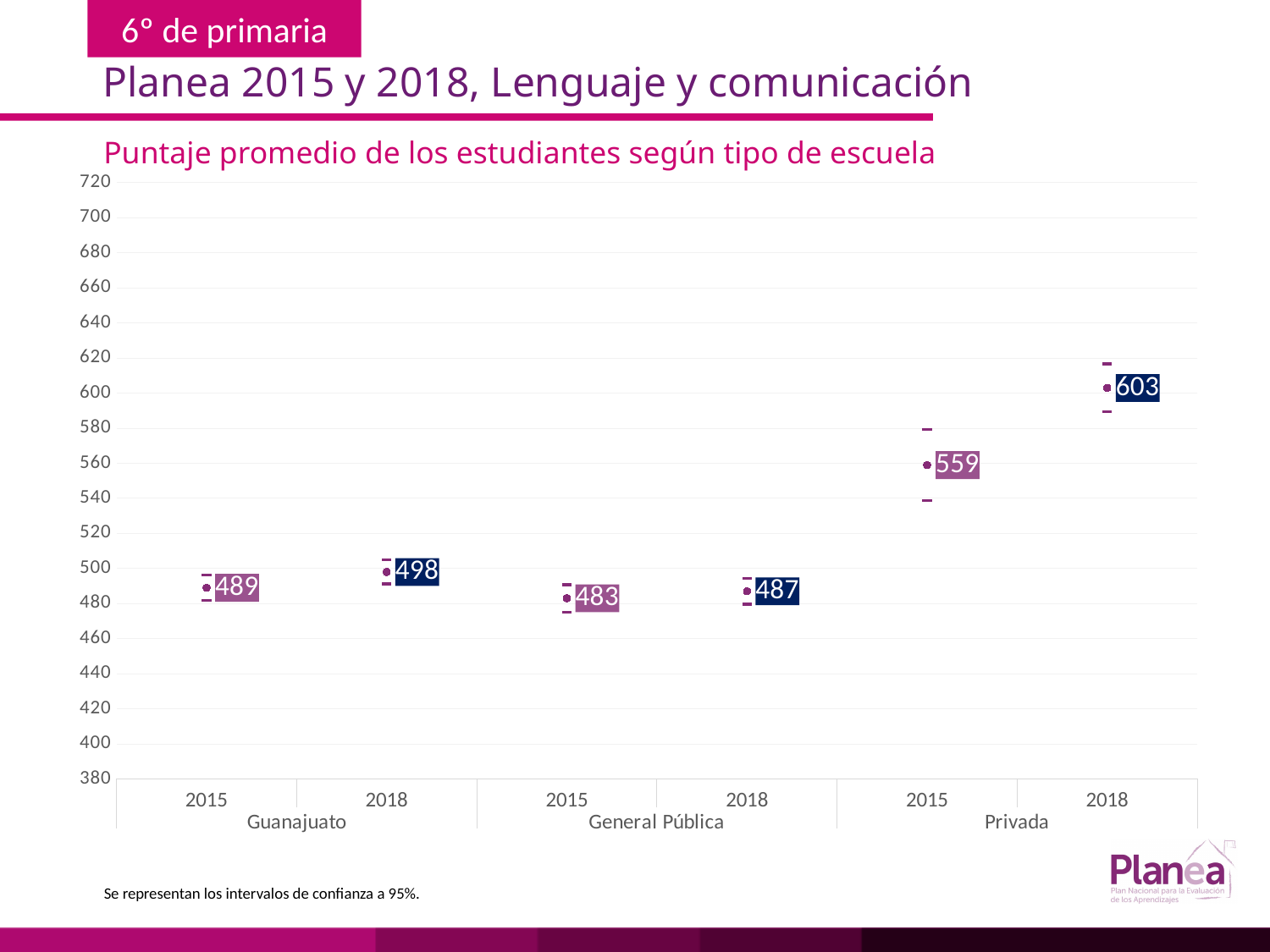
How many data points are plotted on the chart? 6 What is the difference between the Privada scores in 2018 and 2015? 44 What is the average score for Privada in 2018? 603 What is the title of the chart? Puntaje promedio de los estudiantes según tipo de escuela Which is larger, the 2018 score for Guanajuato or the 2018 score for General Pública? Guanajuato What is the average score for Guanajuato in 2018? 498 Which school type and year has the highest average score? Privada 2018 What is the average score for Guanajuato in 2015? 489 What is the average score for General Pública in 2015? 483 Which school type and year has the lowest average score? General Pública 2015 What is the difference between the Guanajuato scores in 2018 and 2015? 9 Does the score for each school type rise or fall from 2015 to 2018? Rise